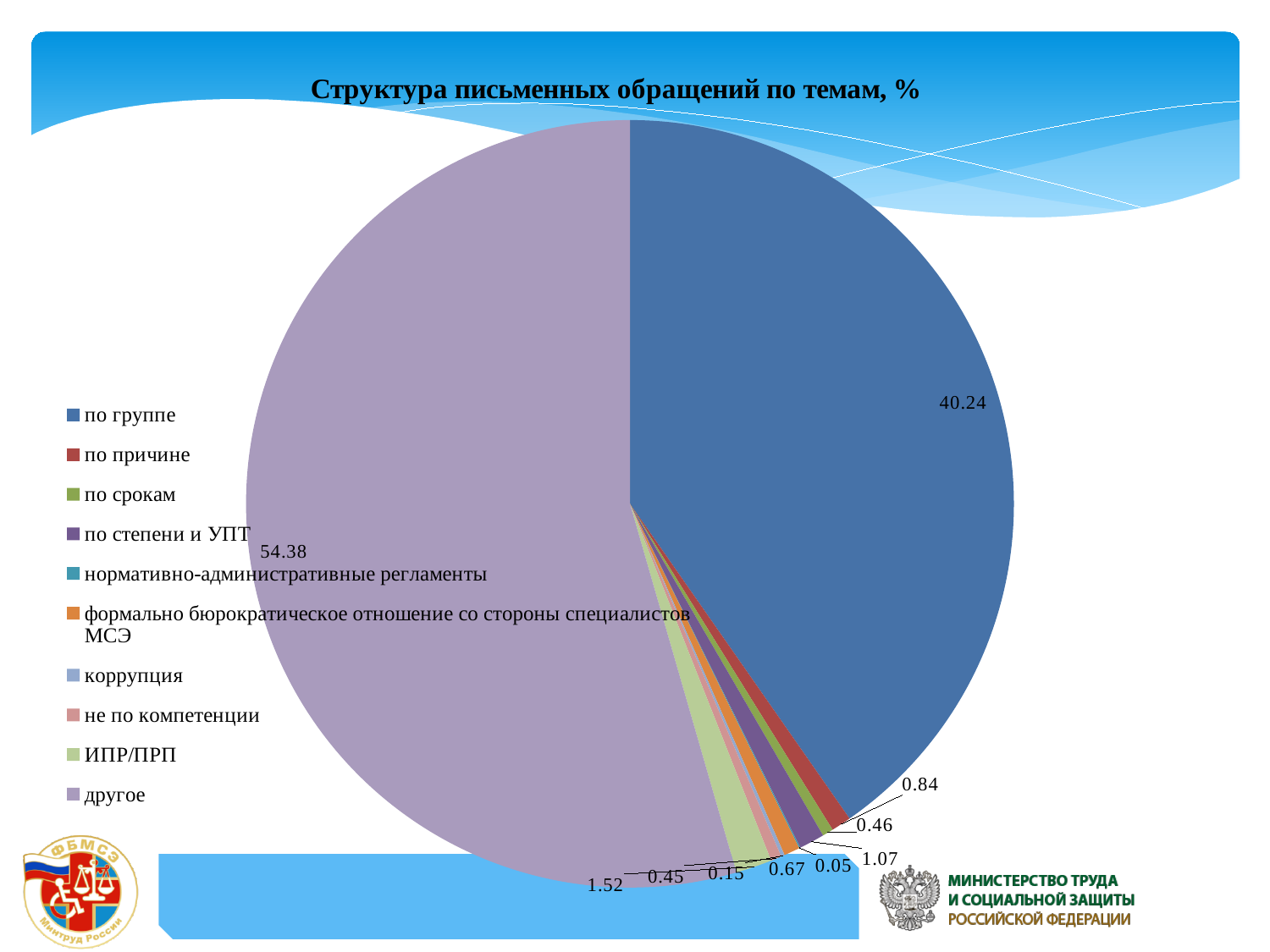
How many categories does the legend of the pie chart list? 10 What kind of chart is shown on the slide? pie chart What is the value shown for the slice "другое"? 54.38 What is the smallest value labelled on the pie chart? 0.05 What is the combined value of the two largest slices, "другое" and "по группе"? 94.62 What is the title of the chart? Структура письменных обращений по темам, % What is the value shown for the slice "ИПР/ПРП"? 1.52 What is the difference between the values for "другое" and "по группе"? 14.14 Which category has the largest slice of the pie? другое What is the value shown for the slice "по группе"? 40.24 Is the value for "по группе" greater or less than 50? less Which is larger, the slice for "по группе" or the slice for "другое"? другое